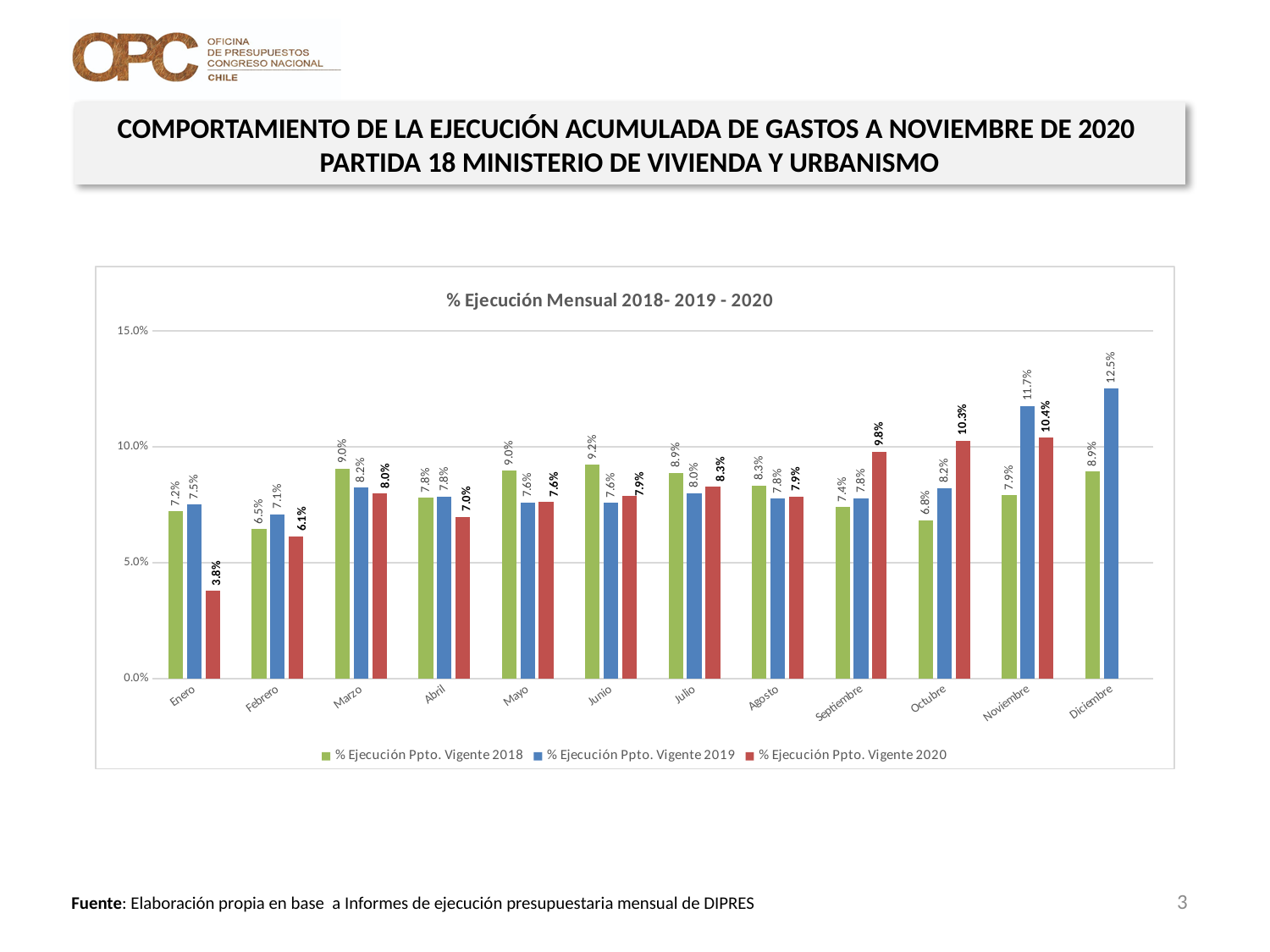
Is the value for % Ejecución Ppto. Vigente 2019 in Diciembre greater or less than 10.0%? greater Which month has the highest value for % Ejecución Ppto. Vigente 2019? Diciembre What is the difference between the 2019 and 2020 values in Noviembre? 1.3% In Octubre, which series is larger: % Ejecución Ppto. Vigente 2018 or % Ejecución Ppto. Vigente 2020? % Ejecución Ppto. Vigente 2020 What kind of chart is shown on the slide? Bar chart Which month has the lowest value for % Ejecución Ppto. Vigente 2018? Febrero Which month has the lowest value for % Ejecución Ppto. Vigente 2020? Enero How many months are shown on the x axis? 12 What is the value for % Ejecución Ppto. Vigente 2020 in Enero? 3.8% What is the value for % Ejecución Ppto. Vigente 2019 in Noviembre? 11.7% How many series does the legend list? 3 What is the value for % Ejecución Ppto. Vigente 2018 in Junio? 9.2%